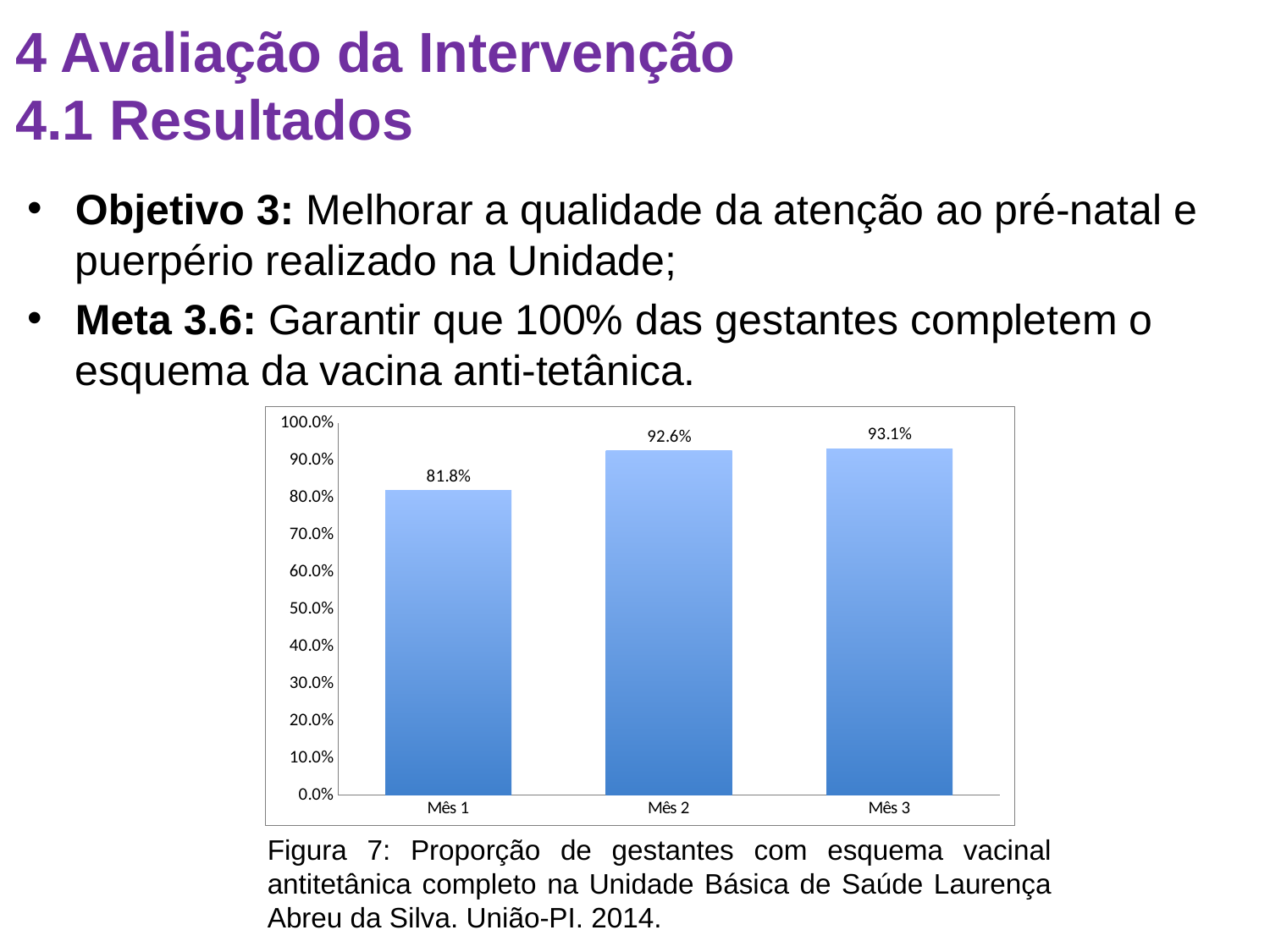
What is the value for Mês 1? 81.8% How many months are shown on the x axis? 3 Which is larger, the value for Mês 1 or the value for Mês 2? Mês 2 What is the difference between the values for Mês 3 and Mês 2? 0.5% Which month has the lowest value? Mês 1 Do the values rise or fall from Mês 1 to Mês 3? rise What is the value for Mês 3? 93.1% Which month has the highest value? Mês 3 What is the difference between the values for Mês 2 and Mês 1? 10.8% Is the value for Mês 1 greater or less than 80.0%? greater What is the value for Mês 2? 92.6% What kind of chart is shown on the slide? bar chart